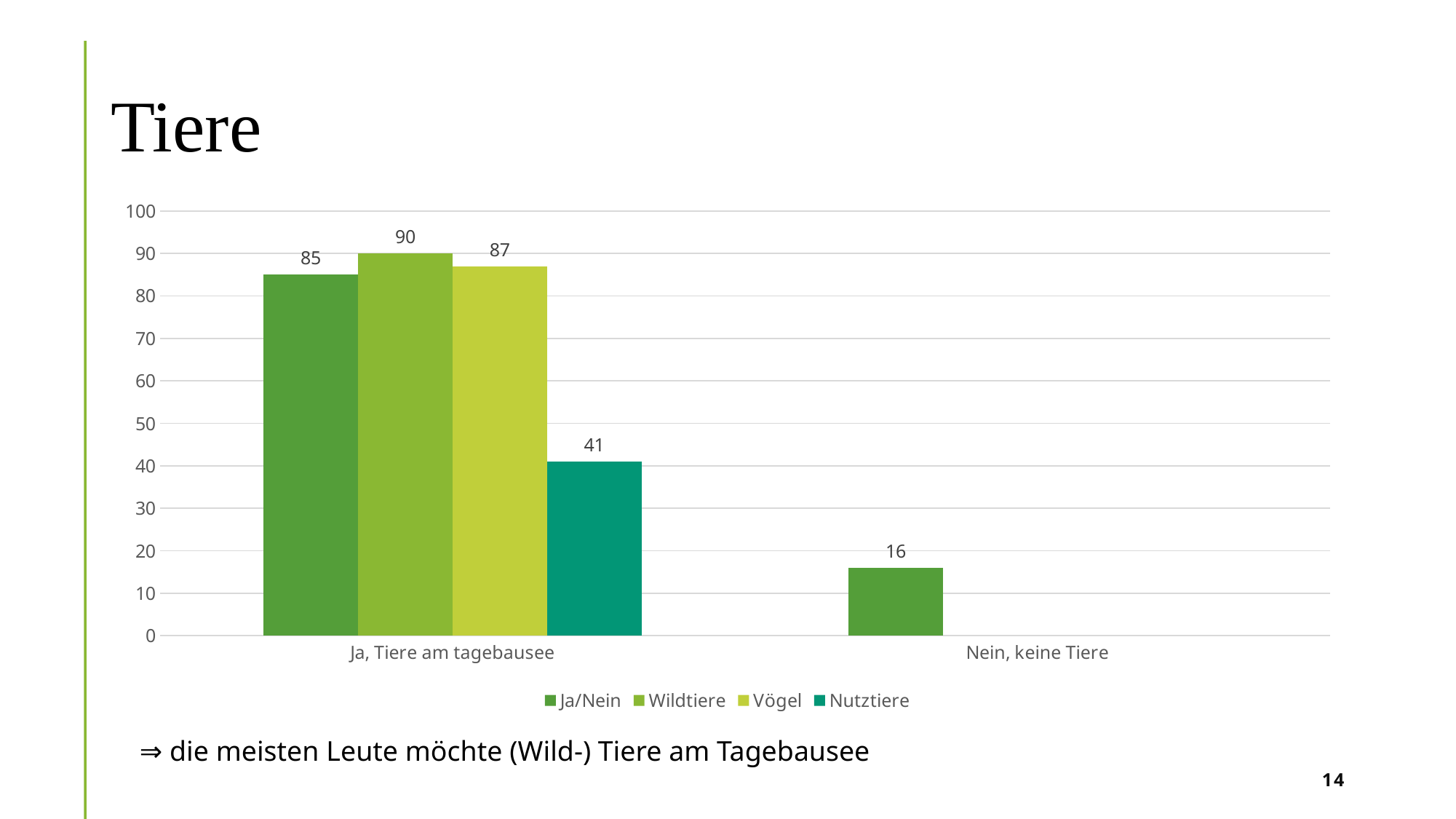
What is the value of the Wildtiere series for "Ja, Tiere am tagebausee"? 90 What is the difference between the Wildtiere value and the Nutztiere value for "Ja, Tiere am tagebausee"? 49 How many series does the legend list? 4 Which is larger: the Vögel value or the Nutztiere value for "Ja, Tiere am tagebausee"? Vögel What is the value of the Vögel series for "Ja, Tiere am tagebausee"? 87 Which series has the highest value for "Ja, Tiere am tagebausee"? Wildtiere What kind of chart is shown on the slide? Bar chart What is the value of the Ja/Nein series for "Nein, keine Tiere"? 16 What is the value of the Ja/Nein series for the category "Ja, Tiere am tagebausee"? 85 Which series has the lowest value for "Ja, Tiere am tagebausee"? Nutztiere What is the value of the Nutztiere series for "Ja, Tiere am tagebausee"? 41 What is the difference between the Ja/Nein values for "Ja, Tiere am tagebausee" and "Nein, keine Tiere"? 69